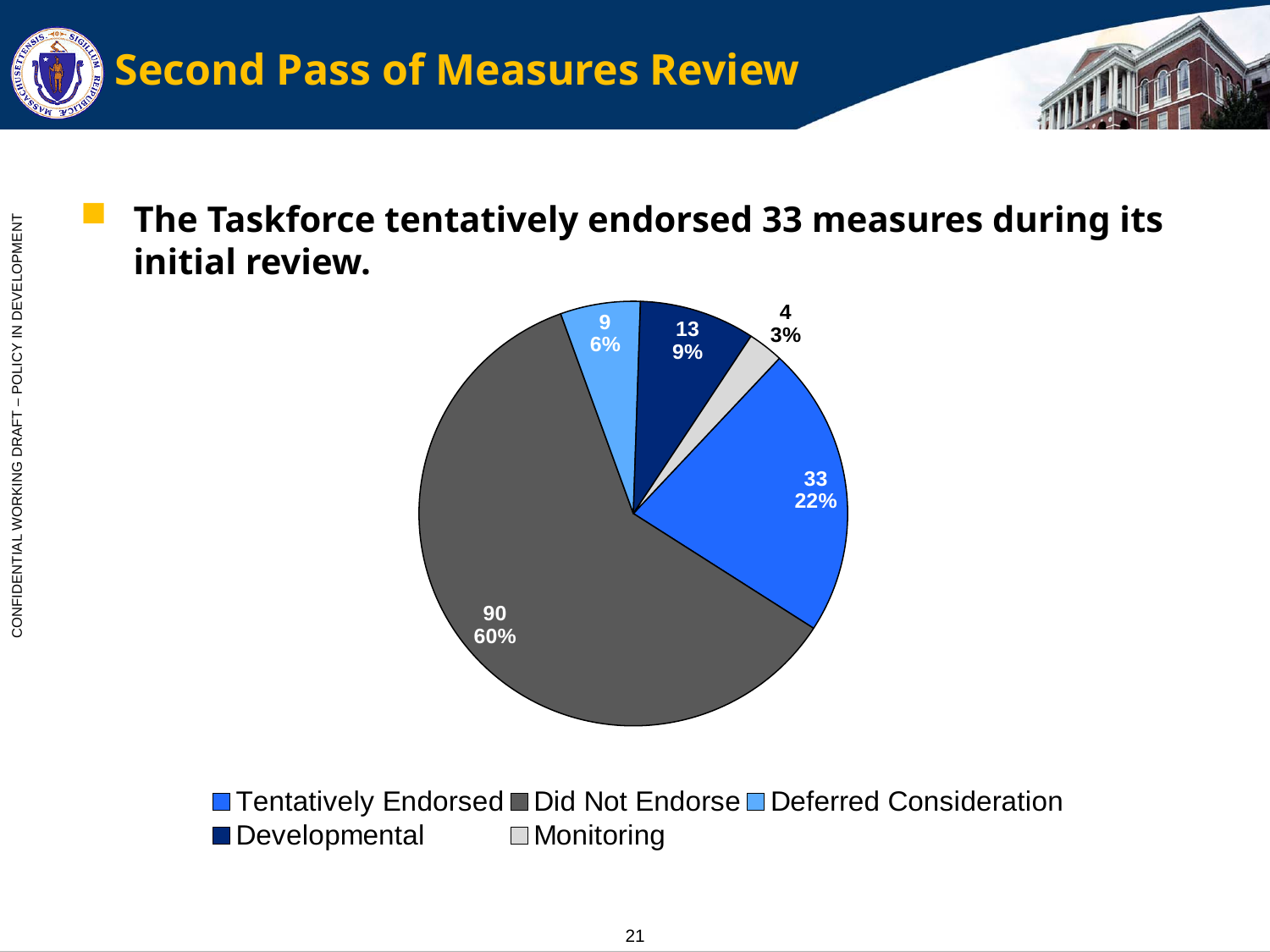
What share of the pie is Developmental? 9% How many measures fall under Did Not Endorse? 90 Which category has the smallest slice of the pie? Monitoring Which category has the largest slice of the pie? Did Not Endorse How many categories does the pie chart have? 5 What kind of chart is shown on the slide? pie chart Which is larger, the Developmental count or the Deferred Consideration count? Developmental How many measures are in the Monitoring category? 4 What is the difference between the number of Did Not Endorse measures and Tentatively Endorsed measures? 57 What is the total number of measures across all slices of the pie? 149 How many measures were Tentatively Endorsed? 33 What share of the pie is Did Not Endorse? 60%